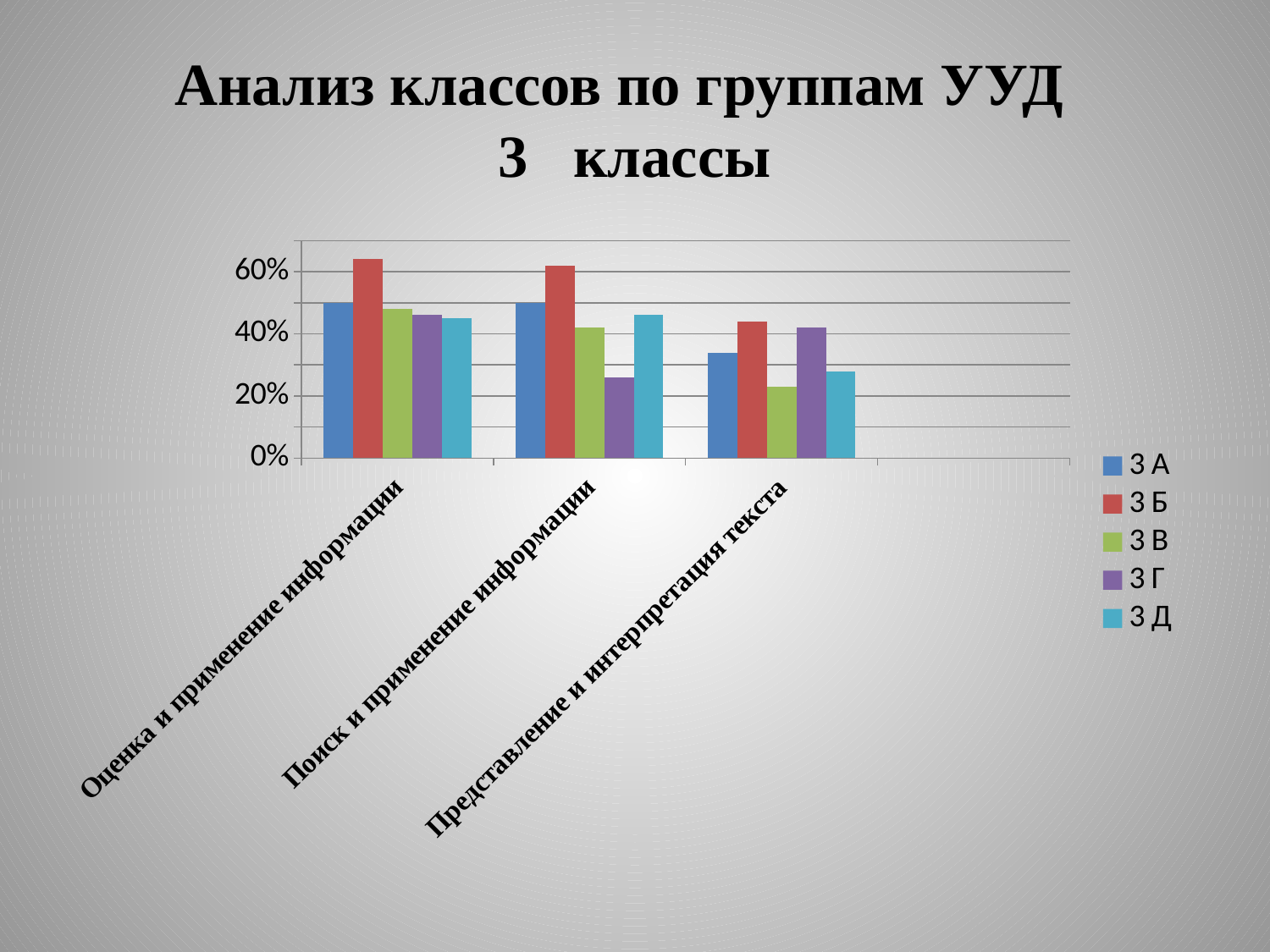
Is the value for 3 Б in "Оценка и применение информации" greater or less than 60%? greater How many series does the legend list? 5 Which colour represents the series 3 Д in the legend? light blue In "Поиск и применение информации", which is larger: the value for 3 А or the value for 3 Г? 3 А What kind of chart is shown on the slide? bar chart Which class has the highest value for "Оценка и применение информации"? 3 Б Which class has the highest value for "Представление и интерпретация текста"? 3 Б Which class has the lowest value for "Поиск и применение информации"? 3 Г How many categories are shown on the x axis of the chart? 3 Is the value for 3 Г in "Поиск и применение информации" greater or less than 40%? less Which class has the lowest value for "Представление и интерпретация текста"? 3 В Is the value for 3 В in "Представление и интерпретация текста" greater or less than 40%? less